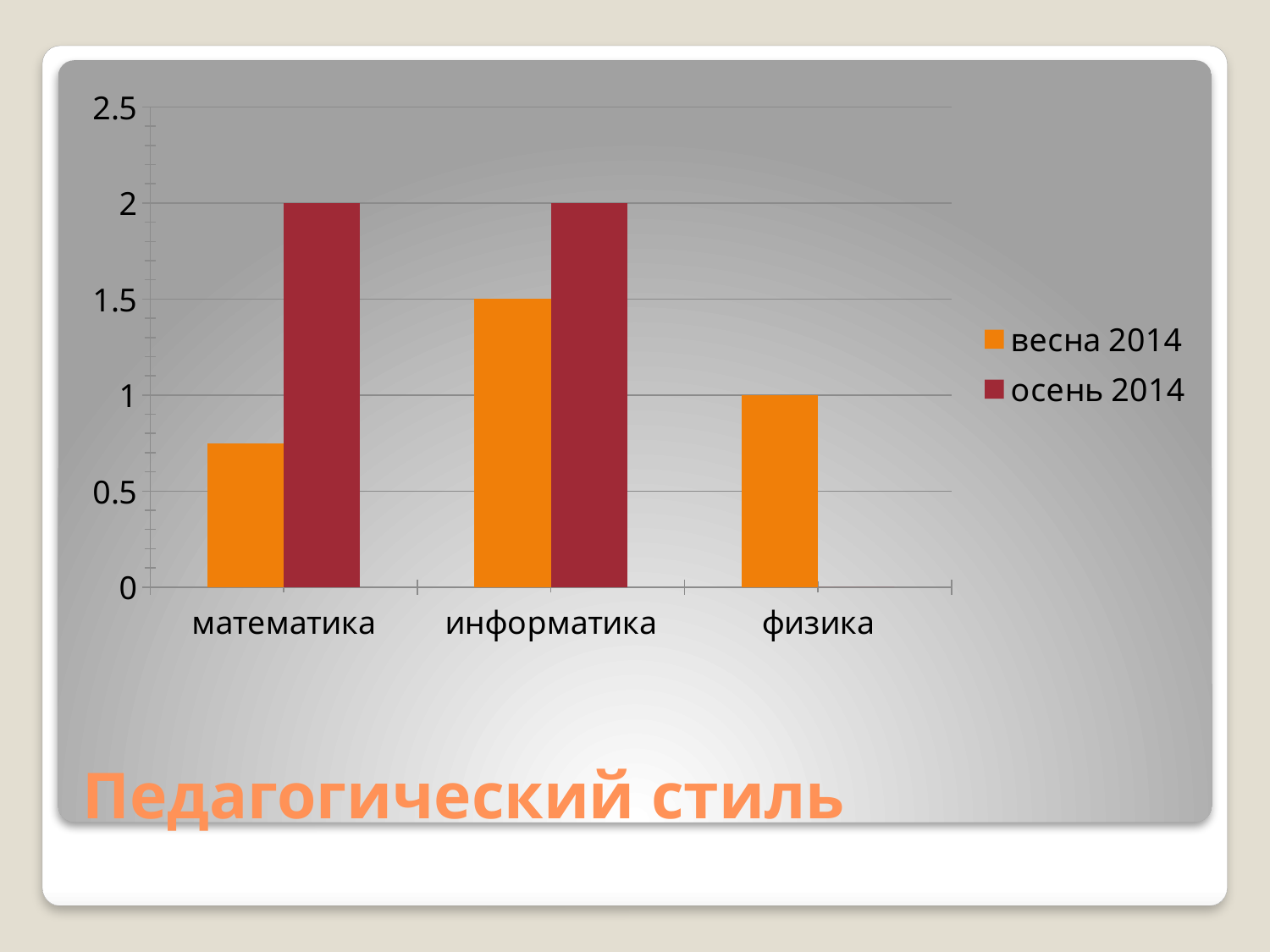
Which category has the highest value for весна 2014? информатика How many categories are shown on the x axis? 3 What is the value for осень 2014 in информатика? 2 What is the value for весна 2014 in информатика? 1.5 In математика, which series has the larger value, весна 2014 or осень 2014? осень 2014 What is the value for осень 2014 in математика? 2 Which category has the lowest value for весна 2014? математика How many series does the legend list? 2 In информатика, what is the difference between the осень 2014 and весна 2014 values? 0.5 What kind of chart is shown on the slide? bar chart What is the value for весна 2014 in физика? 1 Is the value for весна 2014 in математика greater or less than 1? less